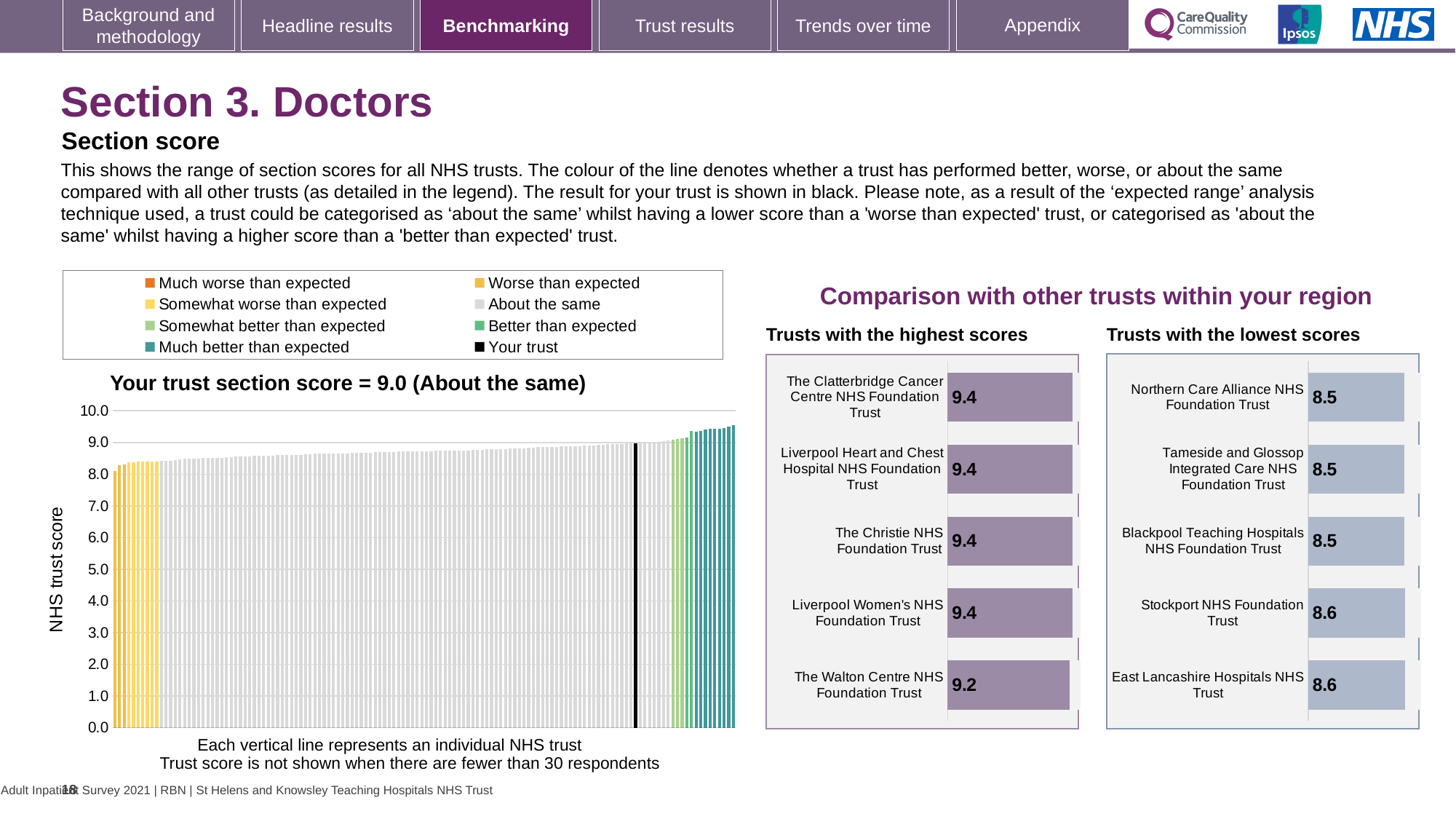
In the 'Trusts with the highest scores' chart, what is the score for The Walton Centre NHS Foundation Trust? 9.2 In the main chart on the left, do the trust scores rise or fall from left to right along the x axis? Rise In the 'Trusts with the highest scores' chart, what is the difference between the scores of The Clatterbridge Cancer Centre NHS Foundation Trust and The Walton Centre NHS Foundation Trust? 0.2 Which has the higher score: The Christie NHS Foundation Trust in the highest scores chart or East Lancashire Hospitals NHS Trust in the lowest scores chart? The Christie NHS Foundation Trust In the main chart on the left, what is your trust's section score? 9.0 What kind of chart is the main chart on the left showing all NHS trusts? Bar chart In the 'Trusts with the highest scores' chart, which trust has the lowest score? The Walton Centre NHS Foundation Trust In the 'Trusts with the lowest scores' chart, what is the difference between the scores of Stockport NHS Foundation Trust and Blackpool Teaching Hospitals NHS Foundation Trust? 0.1 In the 'Trusts with the highest scores' chart, how many trusts are shown? 5 In the 'Trusts with the lowest scores' chart, what is the score for Northern Care Alliance NHS Foundation Trust? 8.5 How many entries does the legend above the main chart on the left list? 8 In the 'Trusts with the lowest scores' chart, what is the score for Stockport NHS Foundation Trust? 8.6